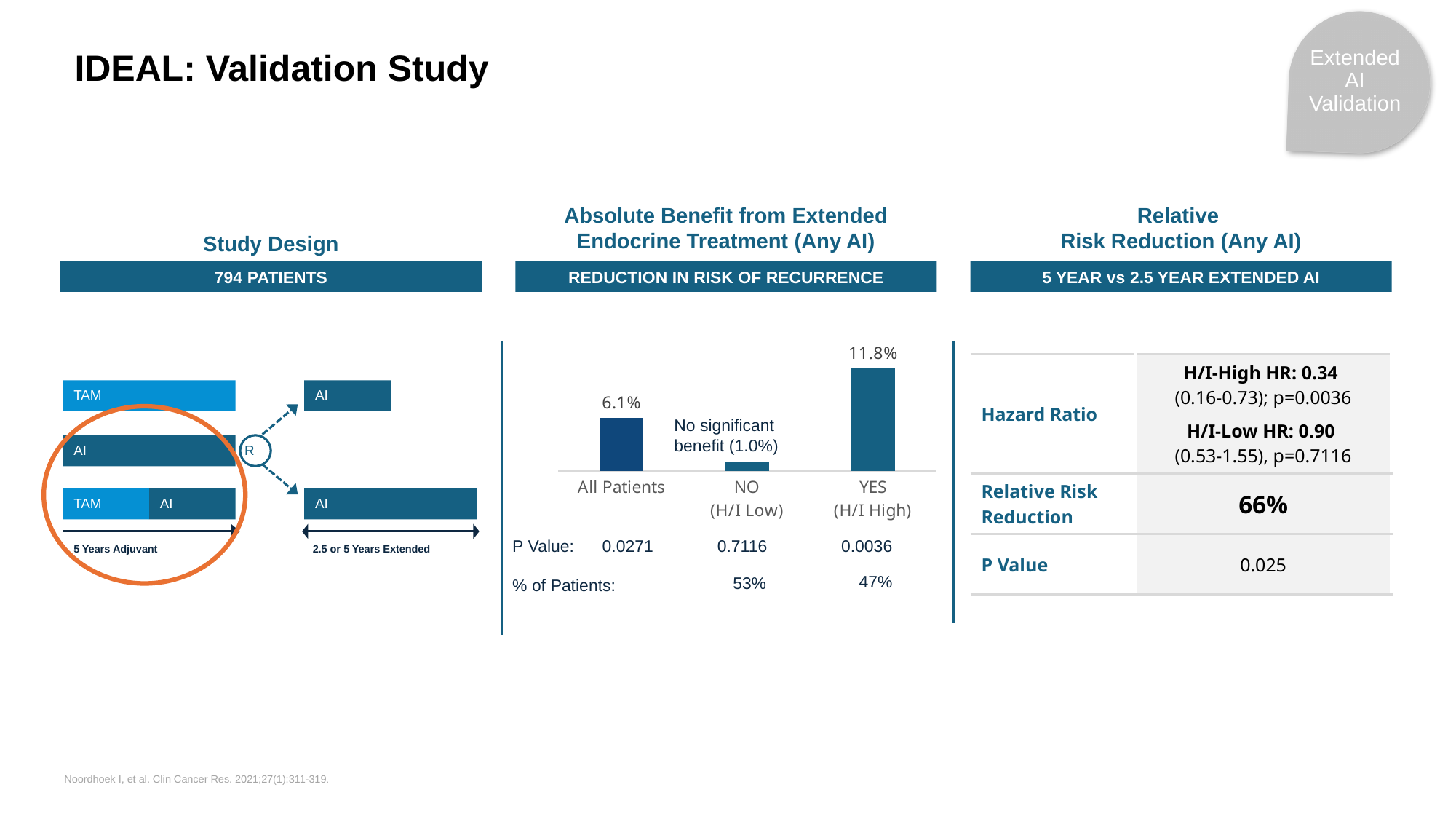
In the Absolute Benefit chart, what is the value for YES (H/I High)? 11.8% In the Absolute Benefit chart, what percentage of patients is listed for the NO (H/I Low) category? 53% In the Absolute Benefit chart, which category has the lowest value? NO (H/I Low) What type of chart is shown under "Absolute Benefit from Extended Endocrine Treatment (Any AI)"? bar chart In the Absolute Benefit chart, what is the value for NO (H/I Low)? 1.0% In the Absolute Benefit chart, what is the value for All Patients? 6.1% In the Absolute Benefit chart, which is larger: the value for All Patients or the value for NO (H/I Low)? All Patients In the Absolute Benefit chart, which category has the highest value? YES (H/I High) In the Absolute Benefit chart, what P value is listed for the YES (H/I High) category? 0.0036 In the Absolute Benefit chart, what is the difference between the All Patients and NO (H/I Low) values? 5.1% In the Absolute Benefit chart, what is the difference between the YES (H/I High) and All Patients values? 5.7% How many categories are shown in the Absolute Benefit chart? 3